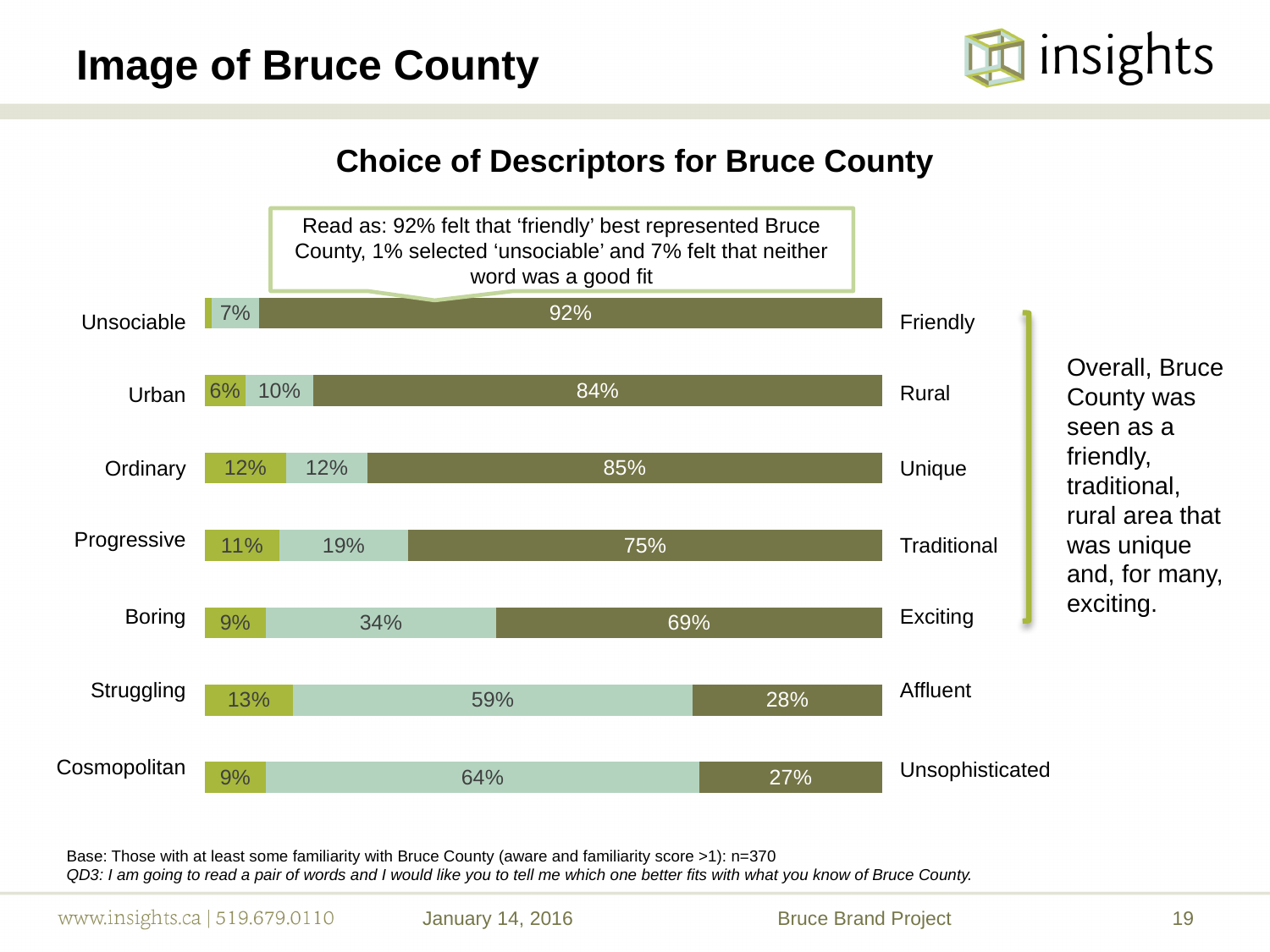
Which received a higher percentage: 'Affluent' or 'Unique'? Unique What percentage felt that 'Friendly' best represented Bruce County? 92% How many pairs of descriptors are shown in the chart? 7 Which right-hand descriptor received the highest percentage? Friendly What percentage felt that neither 'Boring' nor 'Exciting' was a good fit? 34% What is the difference between the percentage selecting 'Exciting' and the percentage selecting 'Boring'? 60% What percentage selected 'Unsophisticated' for Bruce County? 27% What percentage chose 'Rural' over 'Urban' for Bruce County? 84% What percentage selected 'Traditional' for Bruce County? 75% What type of chart is used to show the choice of descriptors? Stacked bar chart What percentage selected 'Struggling' for Bruce County? 13% Which right-hand descriptor received the lowest percentage? Unsophisticated